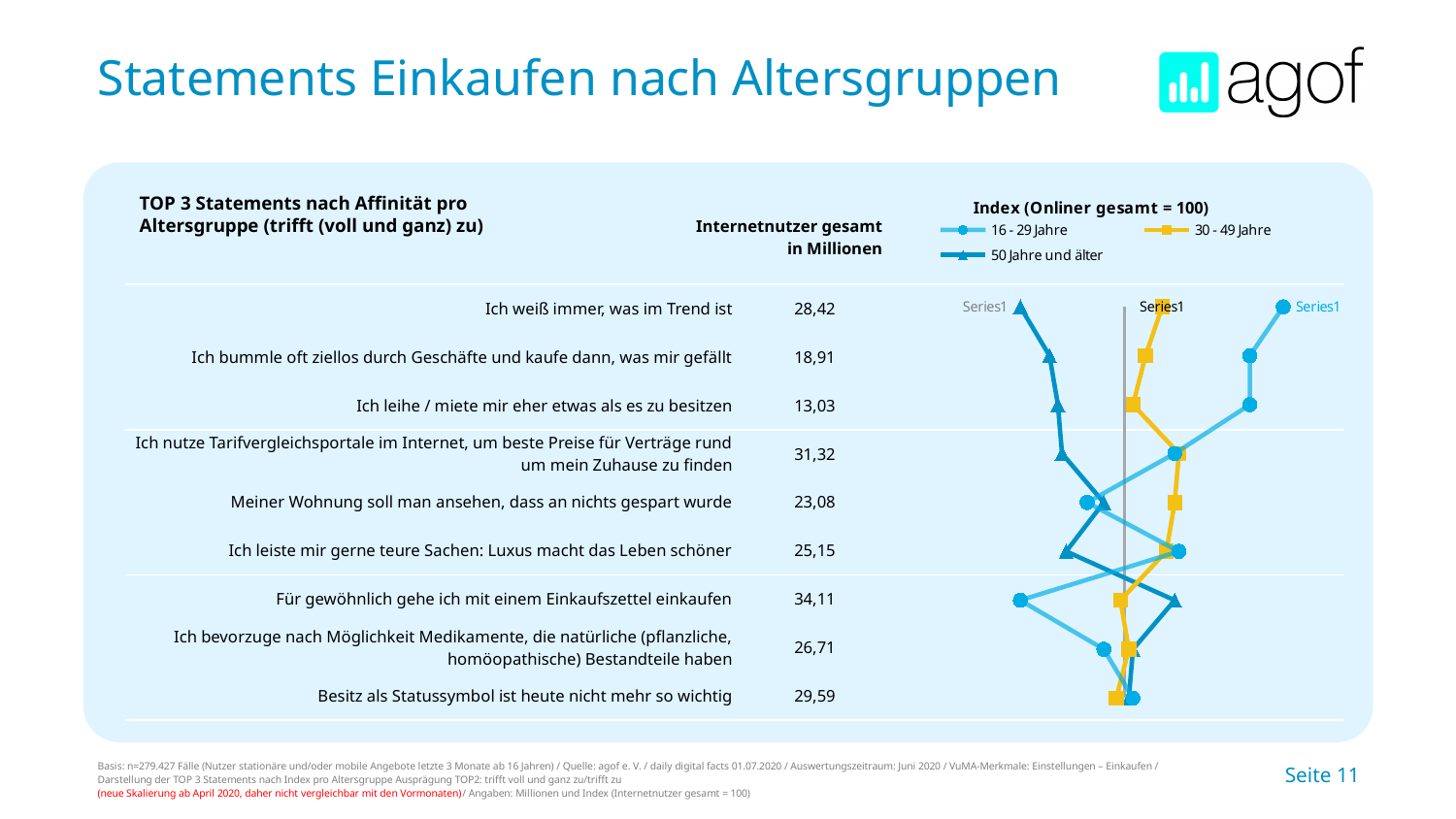
Which statement has the highest 'Internetnutzer gesamt in Millionen' value? Für gewöhnlich gehe ich mit einem Einkaufszettel einkaufen Which age groups are listed in the chart legend? 16 - 29 Jahre, 30 - 49 Jahre, 50 Jahre und älter For 'Für gewöhnlich gehe ich mit einem Einkaufszettel einkaufen', is the index for 16 - 29 Jahre greater or less than 100? less How many statements (categories) are plotted in the chart? 9 For 'Ich weiß immer, was im Trend ist', is the index for 16 - 29 Jahre greater or less than 100? greater For 'Ich weiß immer, was im Trend ist', which age group has the higher index: 16 - 29 Jahre or 50 Jahre und älter? 16 - 29 Jahre What is the difference in 'Internetnutzer gesamt in Millionen' between 'Besitz als Statussymbol ist heute nicht mehr so wichtig' and 'Ich bummle oft ziellos durch Geschäfte und kaufe dann, was mir gefällt'? 10,68 Which statement has the lowest 'Internetnutzer gesamt in Millionen' value? Ich leihe / miete mir eher etwas als es zu besitzen What kind of chart is shown on the right side of the slide? line chart What is the 'Internetnutzer gesamt in Millionen' value for 'Für gewöhnlich gehe ich mit einem Einkaufszettel einkaufen'? 34,11 How many series does the chart legend list? 3 What is the 'Internetnutzer gesamt in Millionen' value for 'Ich weiß immer, was im Trend ist'? 28,42